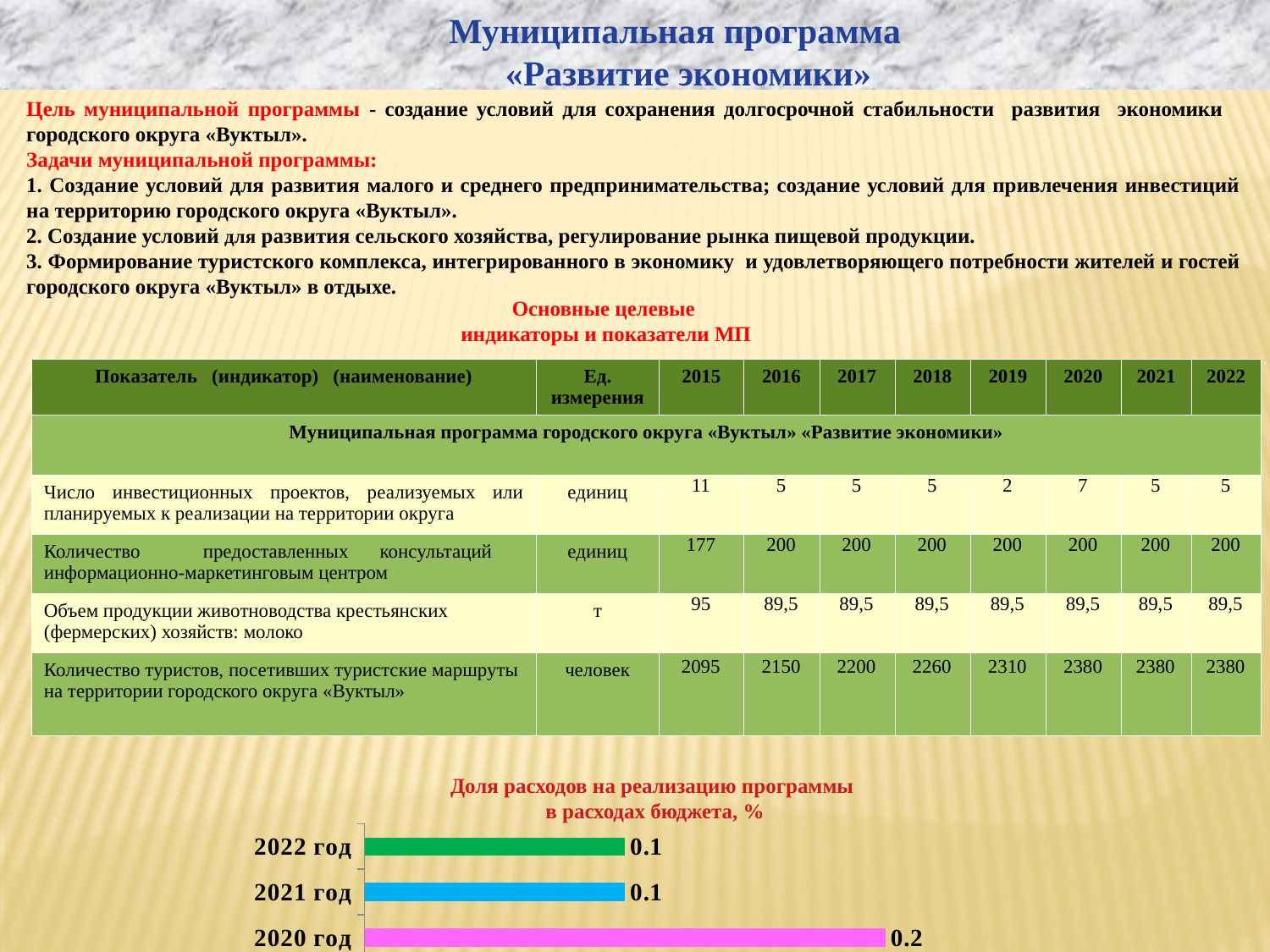
What is the title of the bar chart at the bottom of the slide? Доля расходов на реализацию программы в расходах бюджета, % What is the value for 2021 год in the chart 'Доля расходов на реализацию программы в расходах бюджета, %'? 0.1 What is the value for 2022 год in the chart 'Доля расходов на реализацию программы в расходах бюджета, %'? 0.1 In the chart 'Доля расходов на реализацию программы в расходах бюджета, %', do the values rise or fall from 2020 год to 2022 год? fall What is the value for 2020 год in the chart 'Доля расходов на реализацию программы в расходах бюджета, %'? 0.2 Which year has the highest value in the chart 'Доля расходов на реализацию программы в расходах бюджета, %'? 2020 год What colour is the bar for 2020 год in the chart 'Доля расходов на реализацию программы в расходах бюджета, %'? magenta (pink) What kind of chart is 'Доля расходов на реализацию программы в расходах бюджета, %'? bar chart How many years (bars) are shown in the chart 'Доля расходов на реализацию программы в расходах бюджета, %'? 3 In the chart 'Доля расходов на реализацию программы в расходах бюджета, %', what is the difference between the values for 2020 год and 2021 год? 0.1 In the chart 'Доля расходов на реализацию программы в расходах бюджета, %', which is larger: the value for 2020 год or the value for 2022 год? 2020 год